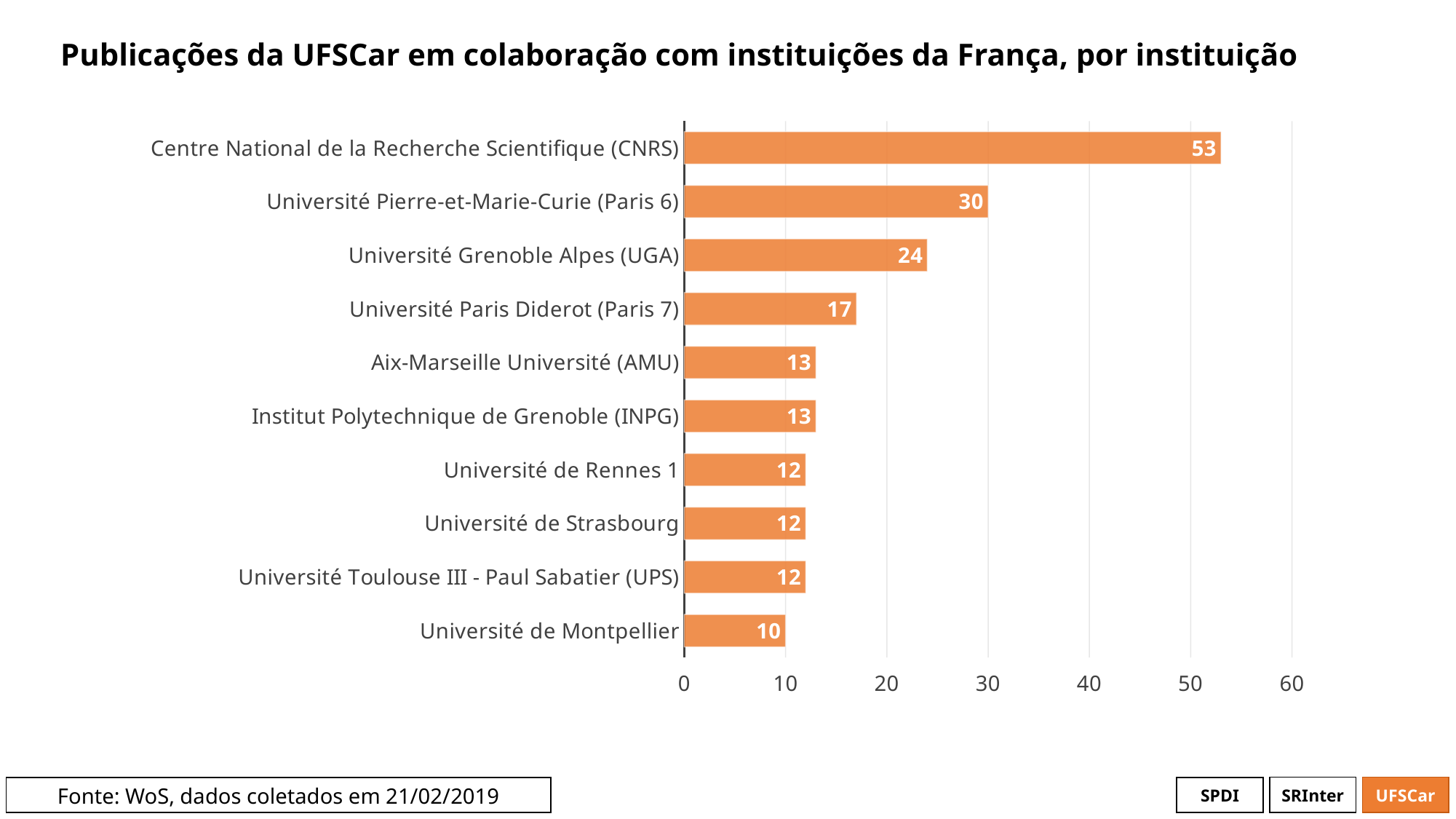
Which institution has the highest number of publications in collaboration with UFSCar? Centre National de la Recherche Scientifique (CNRS) What is the title of the chart? Publicações da UFSCar em colaboração com instituições da França, por instituição Which has a larger value, Université Pierre-et-Marie-Curie (Paris 6) or Université Grenoble Alpes (UGA)? Université Pierre-et-Marie-Curie (Paris 6) What is the value for Université Grenoble Alpes (UGA)? 24 Is the value for Université Paris Diderot (Paris 7) greater or less than 20? less What is the value for Université de Montpellier? 10 What is the difference between the values for CNRS and Université Pierre-et-Marie-Curie (Paris 6)? 23 How many publications does the chart show for Centre National de la Recherche Scientifique (CNRS)? 53 What kind of chart is shown on the slide? bar chart What is the difference between the values for Université Paris Diderot (Paris 7) and Aix-Marseille Université (AMU)? 4 Which institution has the lowest value on the chart? Université de Montpellier How many institutions are shown on the chart? 10